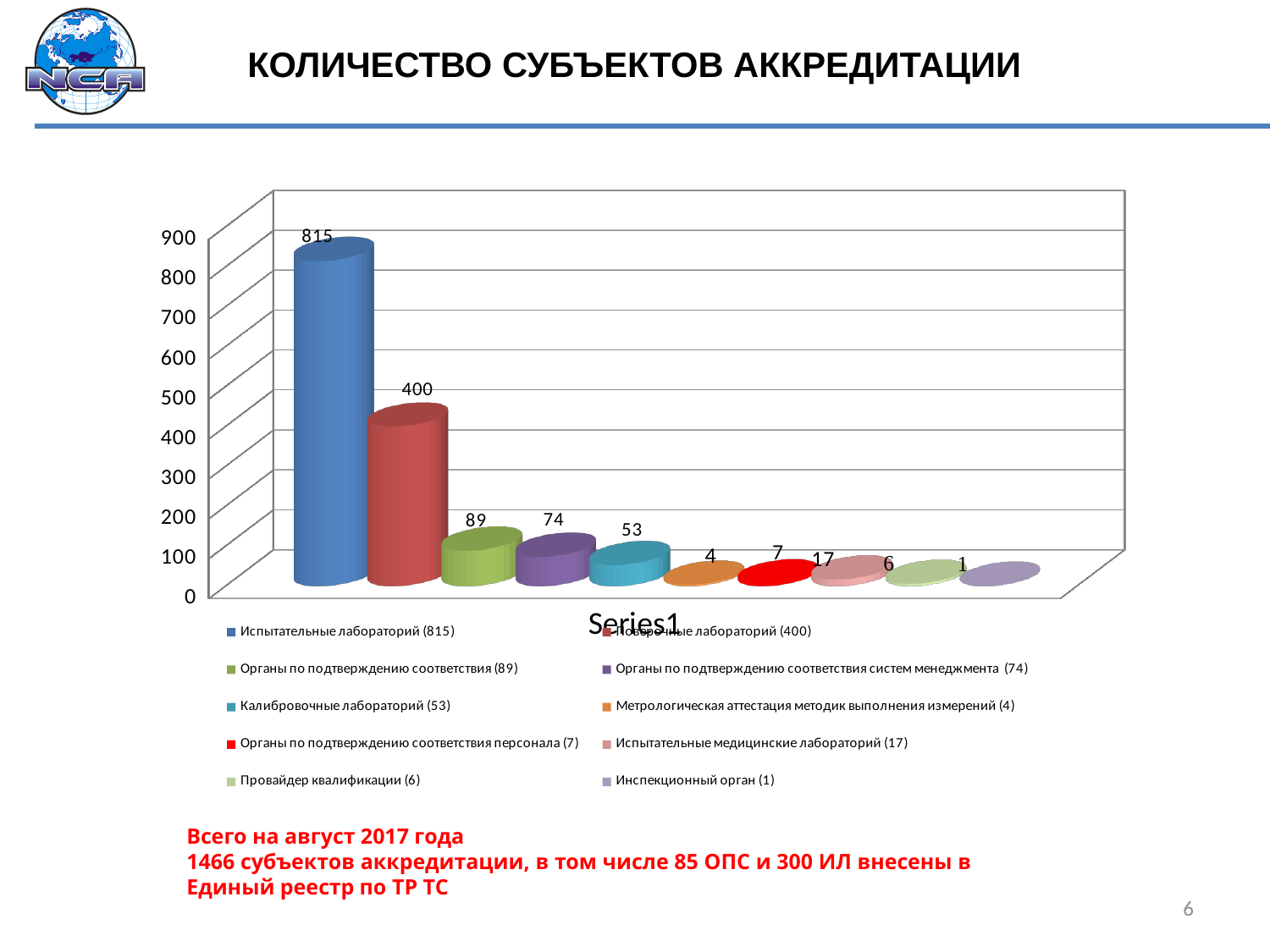
How many bars are plotted in the chart? 10 How many entries does the legend list? 10 Which is larger: the value for Органы по подтверждению соответствия or the value for Органы по подтверждению соответствия систем менеджмента? Органы по подтверждению соответствия What is the value for Испытательные лаборатории? 815 What is the value for Поверочные лаборатории? 400 Which category has the highest value? Испытательные лаборатории What is the value for Калибровочные лаборатории? 53 What is the difference between the values for Испытательные лаборатории and Поверочные лаборатории? 415 What type of chart is shown on the slide? Bar chart Which category has the lowest value? Инспекционный орган What is the title of the slide above the chart? КОЛИЧЕСТВО СУБЪЕКТОВ АККРЕДИТАЦИИ What is the value for Испытательные медицинские лаборатории? 17